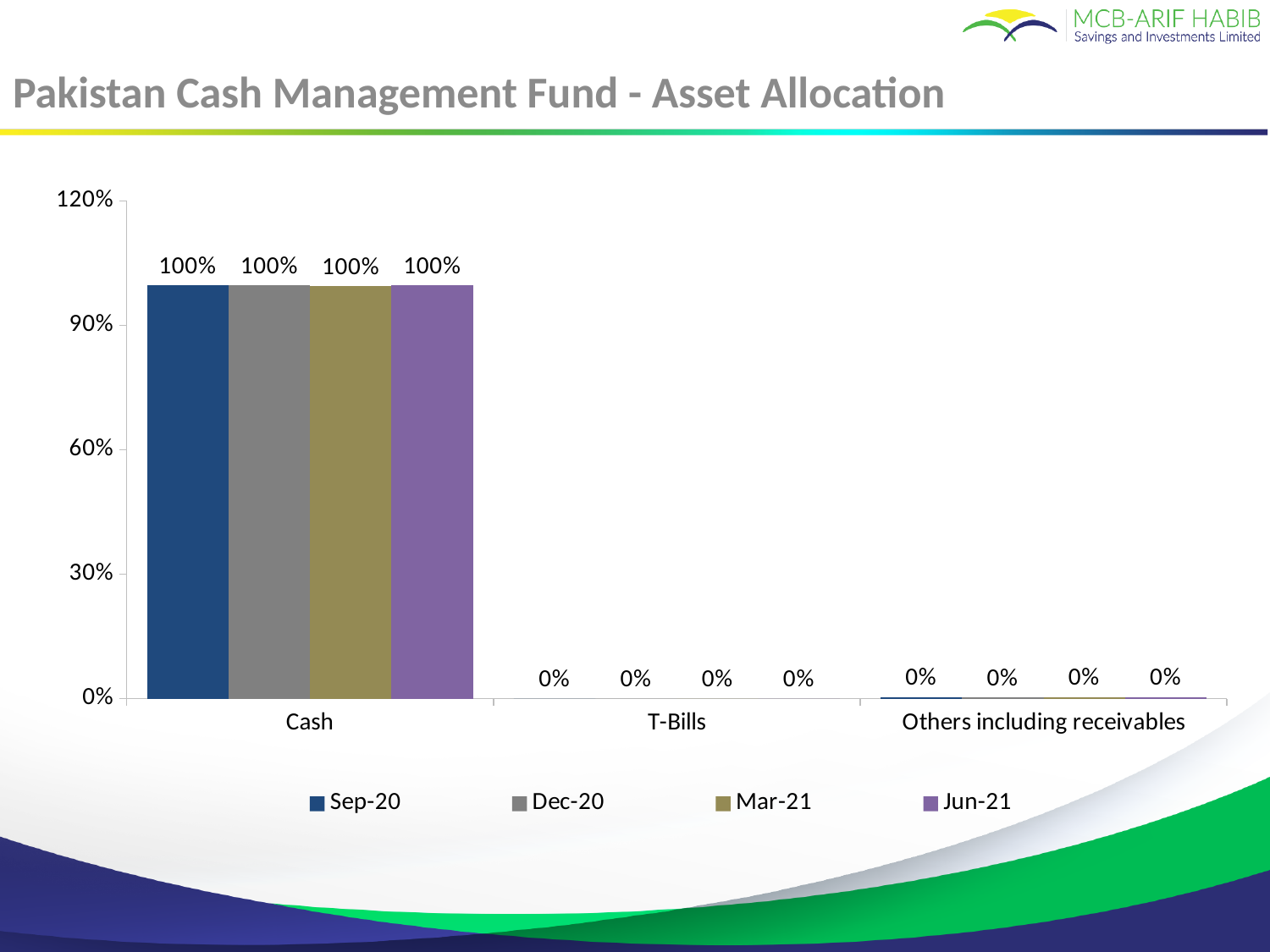
What is the value for Cash in Sep-20? 100% What is the value for Others including receivables in Mar-21? 0% How many categories are shown on the x axis? 3 What is the value for T-Bills in Jun-21? 0% What is the title of the slide? Pakistan Cash Management Fund - Asset Allocation How many series does the legend list? 4 What kind of chart is shown on the slide? Bar chart Which category has the highest value in Jun-21? Cash Which series is shown in purple in the legend? Jun-21 Which is larger in Sep-20: Cash or Others including receivables? Cash What is the difference between the Cash value and the T-Bills value in Mar-21? 100% What is the value for Cash in Dec-20? 100%